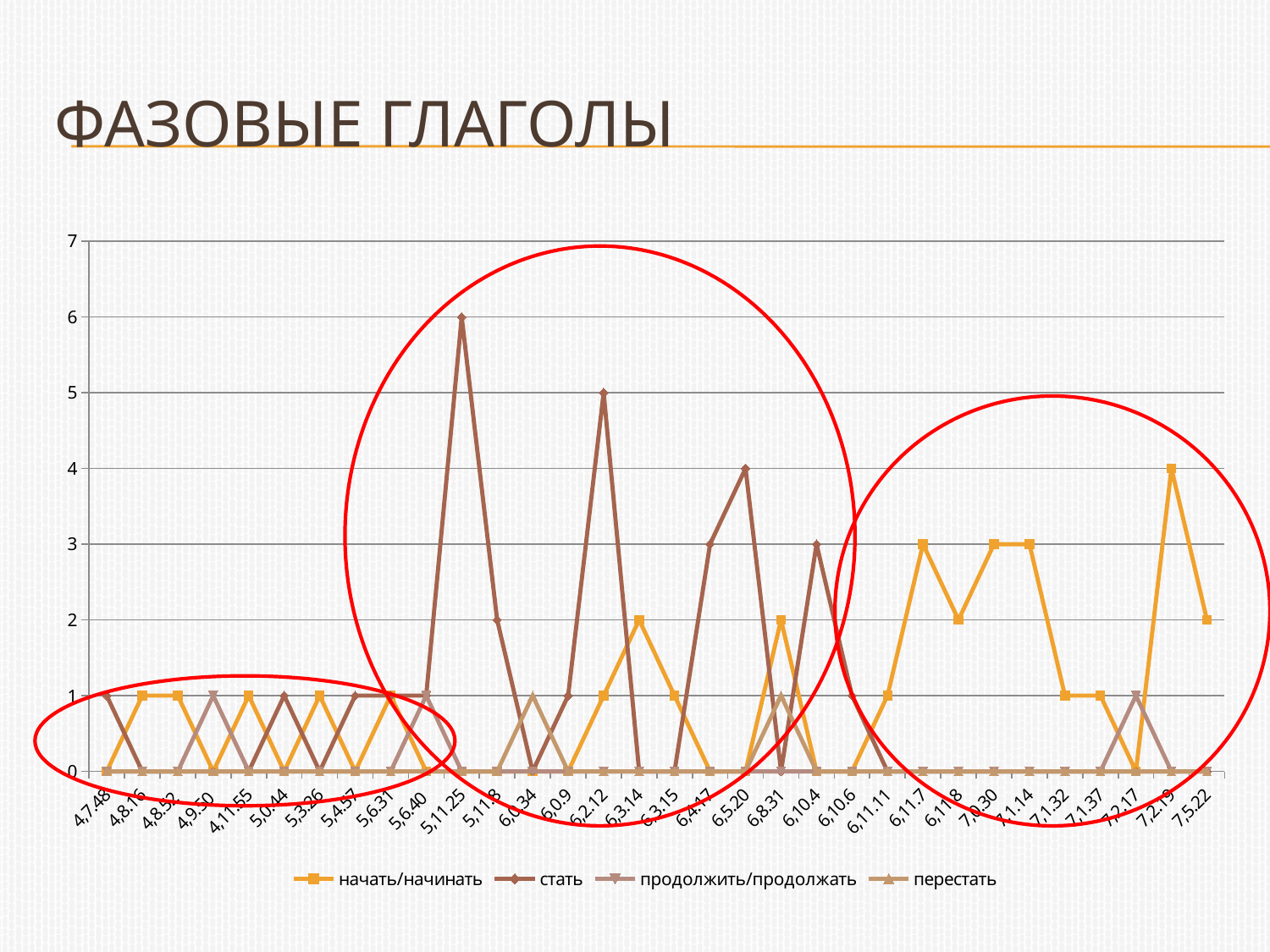
What kind of chart is shown on the slide? line chart What is the difference between the стать value at 5,11.25 and the начать/начинать value at 7,2.19? 2 What is the value of the начать/начинать series at 7,5.22? 2 Is the value of the стать series at 5,11.25 greater or less than 5? greater What is the value of the начать/начинать series at 7,2.19? 4 What is the highest value reached by any series on the chart? 6 At which category does the стать series reach its highest value? 5,11.25 What is the value of the стать series at 5,11.25? 6 How many series does the legend list? 4 Which is larger: the стать value at 6,2.12 or the начать/начинать value at 7,2.19? стать at 6,2.12 What is the title of the slide with the chart? ФАЗОВЫЕ ГЛАГОЛЫ What is the value of the стать series at 6,2.12? 5